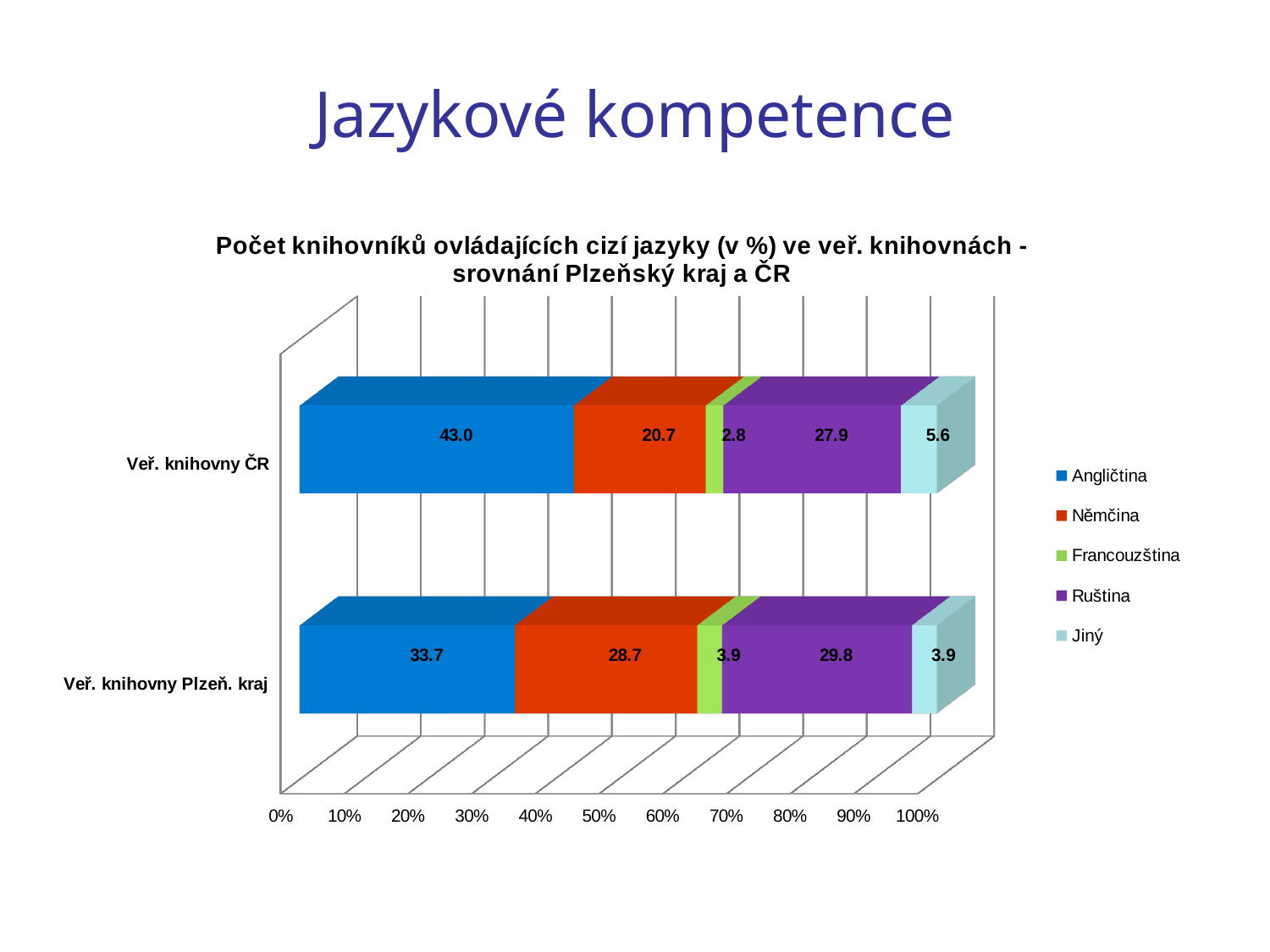
Which language has the largest share for Veř. knihovny ČR? Angličtina Which has a larger Němčina value, Veř. knihovny ČR or Veř. knihovny Plzeň. kraj? Veř. knihovny Plzeň. kraj What is the Jiný value for Veř. knihovny Plzeň. kraj? 3.9 Which language has the smallest share for Veř. knihovny Plzeň. kraj? Francouzština and Jiný (both 3.9) What is the Ruština value for Veř. knihovny ČR? 27.9 How many series does the legend list? 5 How many categories (bars) are shown in the chart? 2 What is the Angličtina value for Veř. knihovny ČR? 43.0 What is the total of the stacked bar for Veř. knihovny Plzeň. kraj? 100.0 What is the Němčina value for Veř. knihovny Plzeň. kraj? 28.7 What is the difference between the Angličtina values for Veř. knihovny ČR and Veř. knihovny Plzeň. kraj? 9.3 What kind of chart is shown on the slide? Stacked bar chart